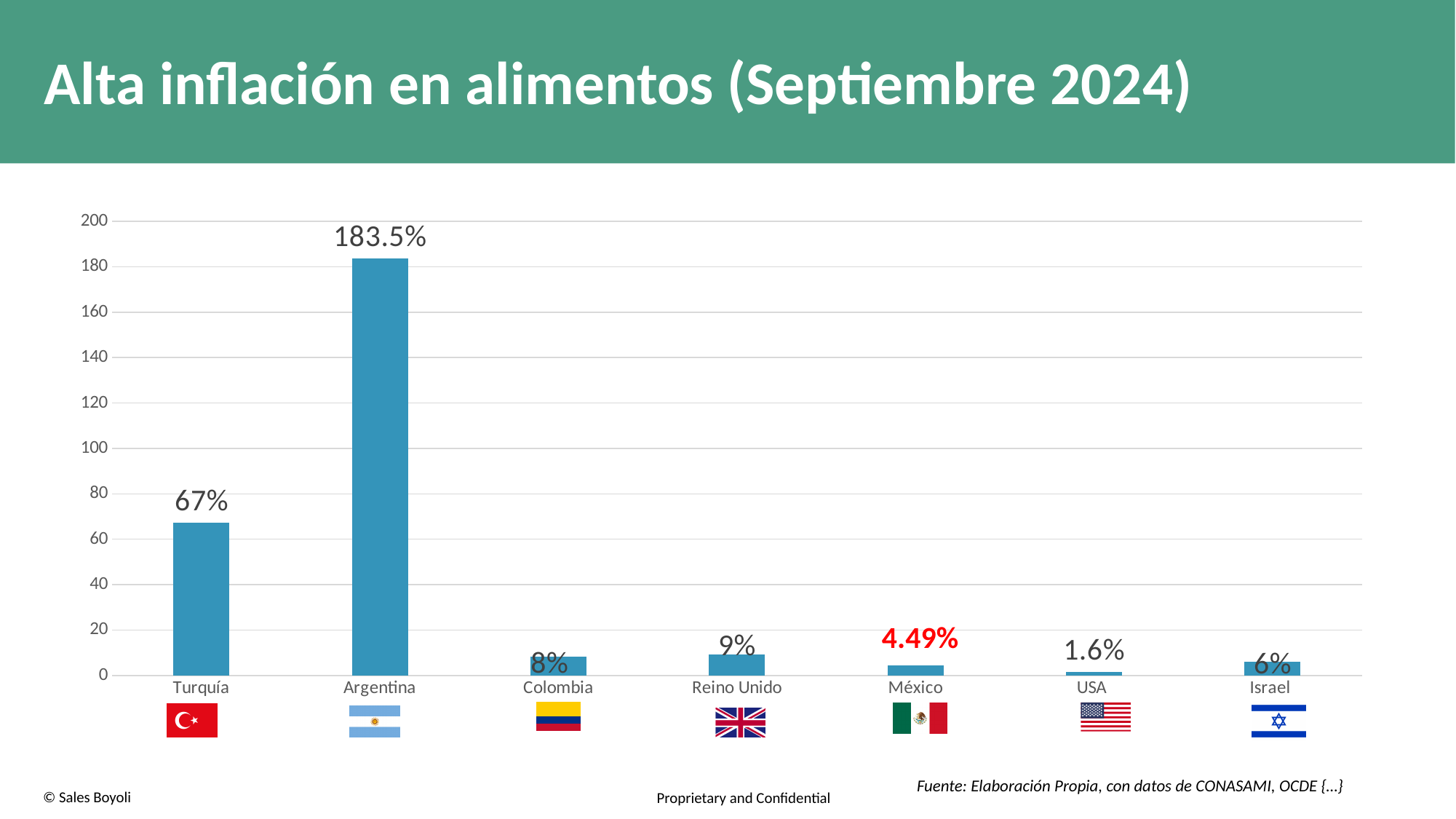
What kind of chart is shown on the slide? Bar chart Which is larger, the value for Reino Unido or the value for Colombia? Reino Unido What is the value shown for México? 4.49% Is the value for Turquía greater or less than 60? greater What is the food inflation value shown for Argentina? 183.5% What is the value shown for Turquía? 67% What is the difference between the values for Argentina and Turquía? 116.5% How many countries are shown on the chart? 7 What is the value shown for USA? 1.6% Which country has the highest food inflation on the chart? Argentina Which country has the lowest food inflation on the chart? USA Which country's data label is shown in red? México